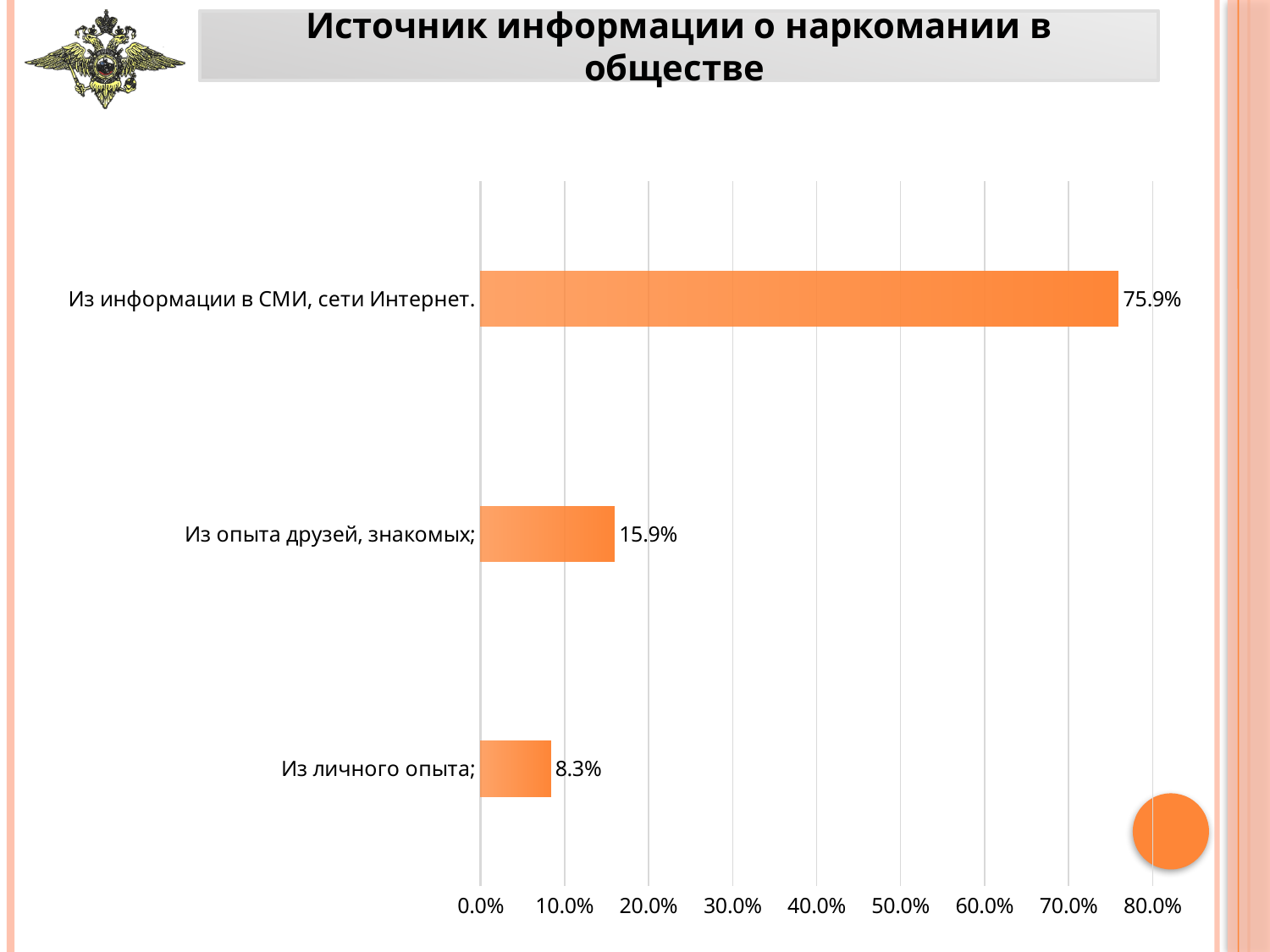
What is the value for "Из информации в СМИ, сети Интернет"? 75.9% What is the value for "Из опыта друзей, знакомых"? 15.9% What is the difference between the values for "Из опыта друзей, знакомых" and "Из личного опыта"? 7.6% Which category has the lowest value? Из личного опыта What is the difference between the values for "Из информации в СМИ, сети Интернет" and "Из опыта друзей, знакомых"? 60.0% How many categories are shown in the chart? 3 What is the title of the slide? Источник информации о наркомании в обществе What kind of chart is shown on the slide? bar chart Which category has the highest value? Из информации в СМИ, сети Интернет Which is larger: the value for "Из опыта друзей, знакомых" or "Из личного опыта"? Из опыта друзей, знакомых Is the value for "Из информации в СМИ, сети Интернет" greater or less than 70.0%? greater What is the value for "Из личного опыта"? 8.3%